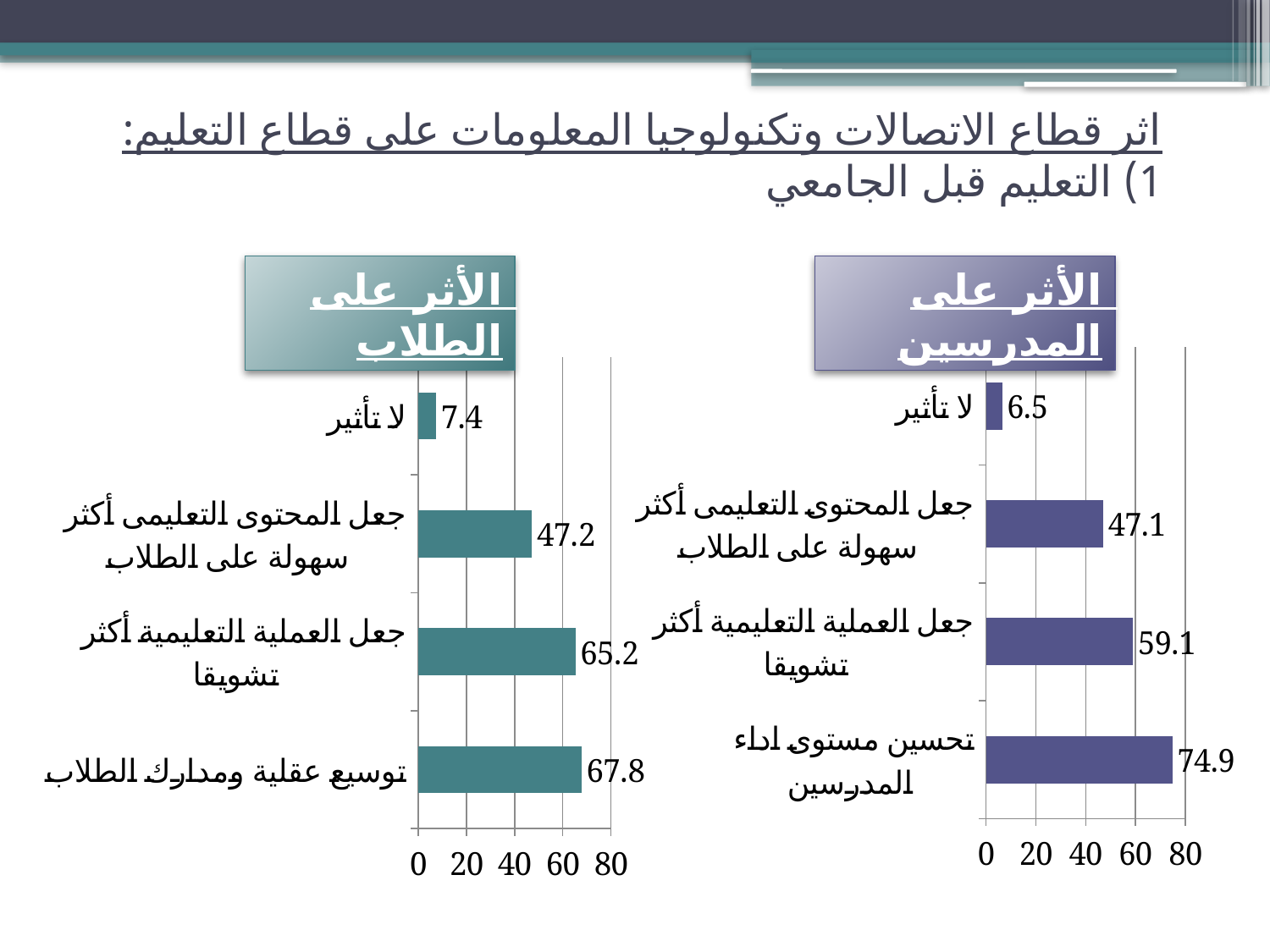
What is the highest tick value shown on the x axis of the chart titled "الأثر على المدرسين"? 80 In the chart titled "الأثر على الطلاب", is the value for "جعل المحتوى التعليمي أكثر سهولة على الطلاب" greater or less than 60? less In the chart titled "الأثر على المدرسين", what is the difference between the values for "تحسين مستوى اداء المدرسين" and "جعل العملية التعليمية أكثر تشويقا"? 15.8 How many categories are shown in the chart titled "الأثر على المدرسين"? 4 In the chart titled "الأثر على الطلاب", what is the value for "لا تأثير"? 7.4 In the chart titled "الأثر على المدرسين", which is larger: the value for "جعل المحتوى التعليمي أكثر سهولة على الطلاب" or the value for "جعل العملية التعليمية أكثر تشويقا"? جعل العملية التعليمية أكثر تشويقا What kind of chart is the chart titled "الأثر على الطلاب"? bar chart In the chart titled "الأثر على المدرسين", what is the value for "تحسين مستوى اداء المدرسين"? 74.9 In the chart titled "الأثر على المدرسين", which category has the lowest value? لا تأثير In the chart titled "الأثر على الطلاب", what is the difference between the values for "توسيع عقلية ومدارك الطلاب" and "لا تأثير"? 60.4 In the chart titled "الأثر على الطلاب", what is the value for "جعل العملية التعليمية أكثر تشويقا"? 65.2 In the chart titled "الأثر على الطلاب", which category has the highest value? توسيع عقلية ومدارك الطلاب